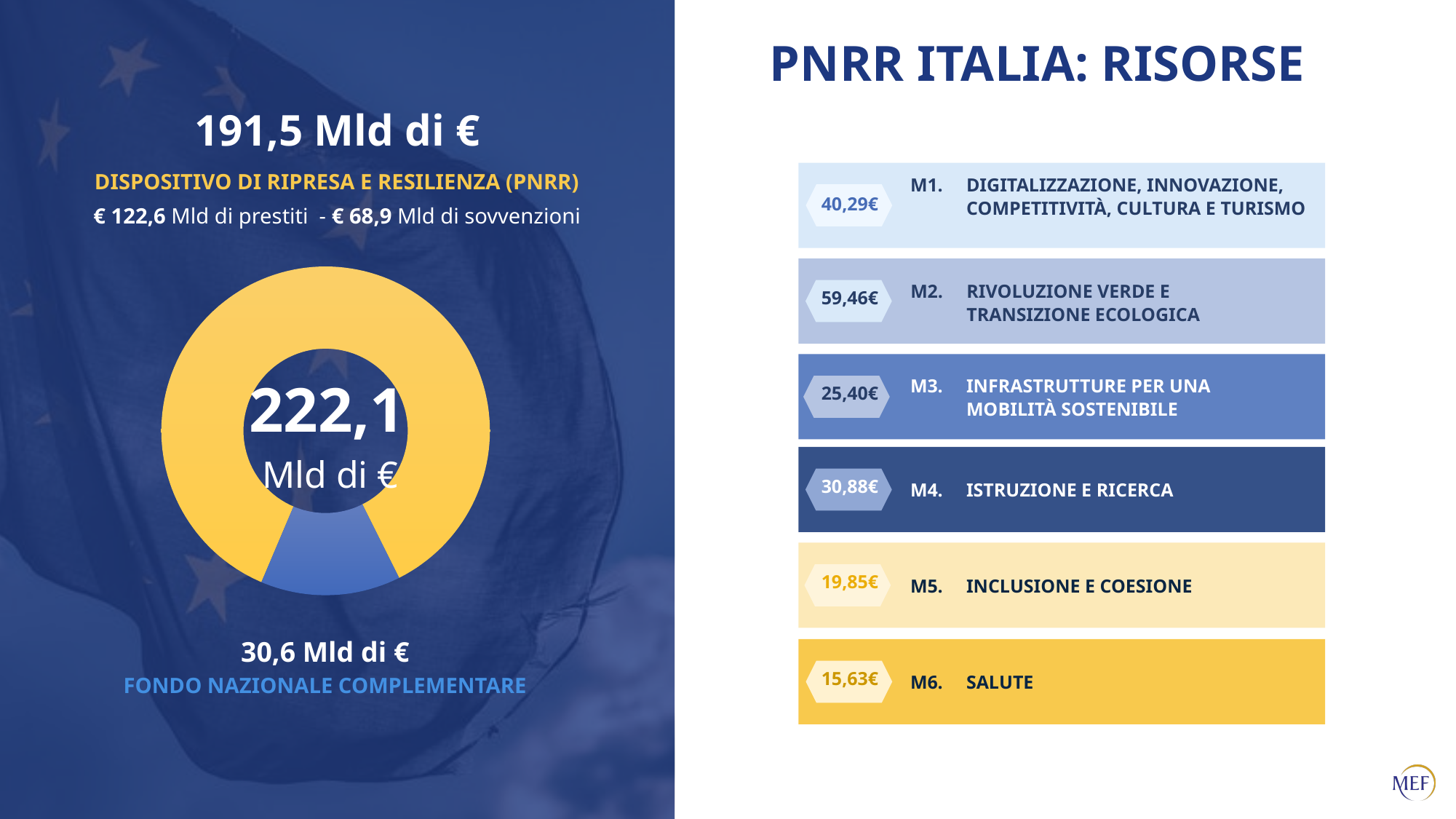
What kind of chart is shown on the left side of the slide? Donut (pie) chart In the donut chart, what is the value of the Dispositivo di Ripresa e Resilienza (PNRR) segment? 191,5 Mld di € In the PNRR Italia: Risorse list on the right, what is the value for M2 Rivoluzione verde e transizione ecologica? 59,46€ In the PNRR Italia: Risorse list on the right, which mission (M1–M6) has the highest value? M2 What colour is the Fondo Nazionale Complementare segment in the donut chart? Blue Which segment of the donut chart has the smallest value? Fondo Nazionale Complementare According to the text above the donut chart, how much of the PNRR is loans (prestiti)? € 122,6 Mld In the donut chart, which segment is larger: PNRR or Fondo Nazionale Complementare? PNRR How many segments does the donut chart have? 2 What is the difference between the PNRR value and the Fondo Nazionale Complementare value in the donut chart? 160,9 Mld di € What total is shown in the centre of the donut chart? 222,1 Mld di € In the donut chart, what is the value of the Fondo Nazionale Complementare segment? 30,6 Mld di €